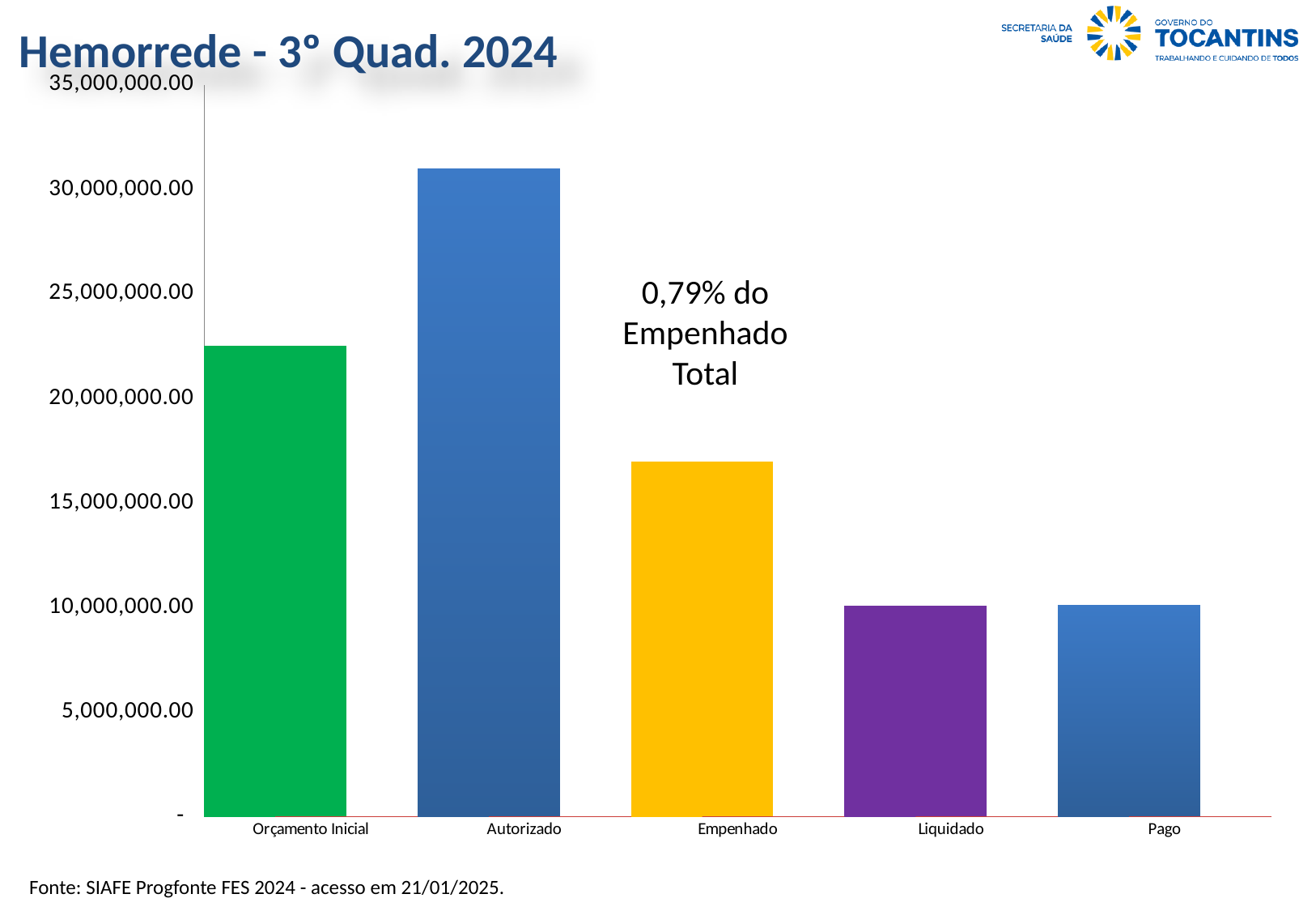
Is the value for Empenhado greater or less than 15,000,000.00? greater Is the value for Orçamento Inicial greater or less than 20,000,000.00? greater Which category has the highest value on the chart? Autorizado Which is larger, the value for Autorizado or the value for Orçamento Inicial? Autorizado How many categories are plotted on the chart? 5 Is the value for Empenhado greater or less than 20,000,000.00? less What is the title of the chart? Hemorrede - 3° Quad. 2024 Which is larger, the value for Orçamento Inicial or the value for Empenhado? Orçamento Inicial What kind of chart is shown on the slide? bar chart What text annotation is shown above the Empenhado bar? 0,79% do Empenhado Total